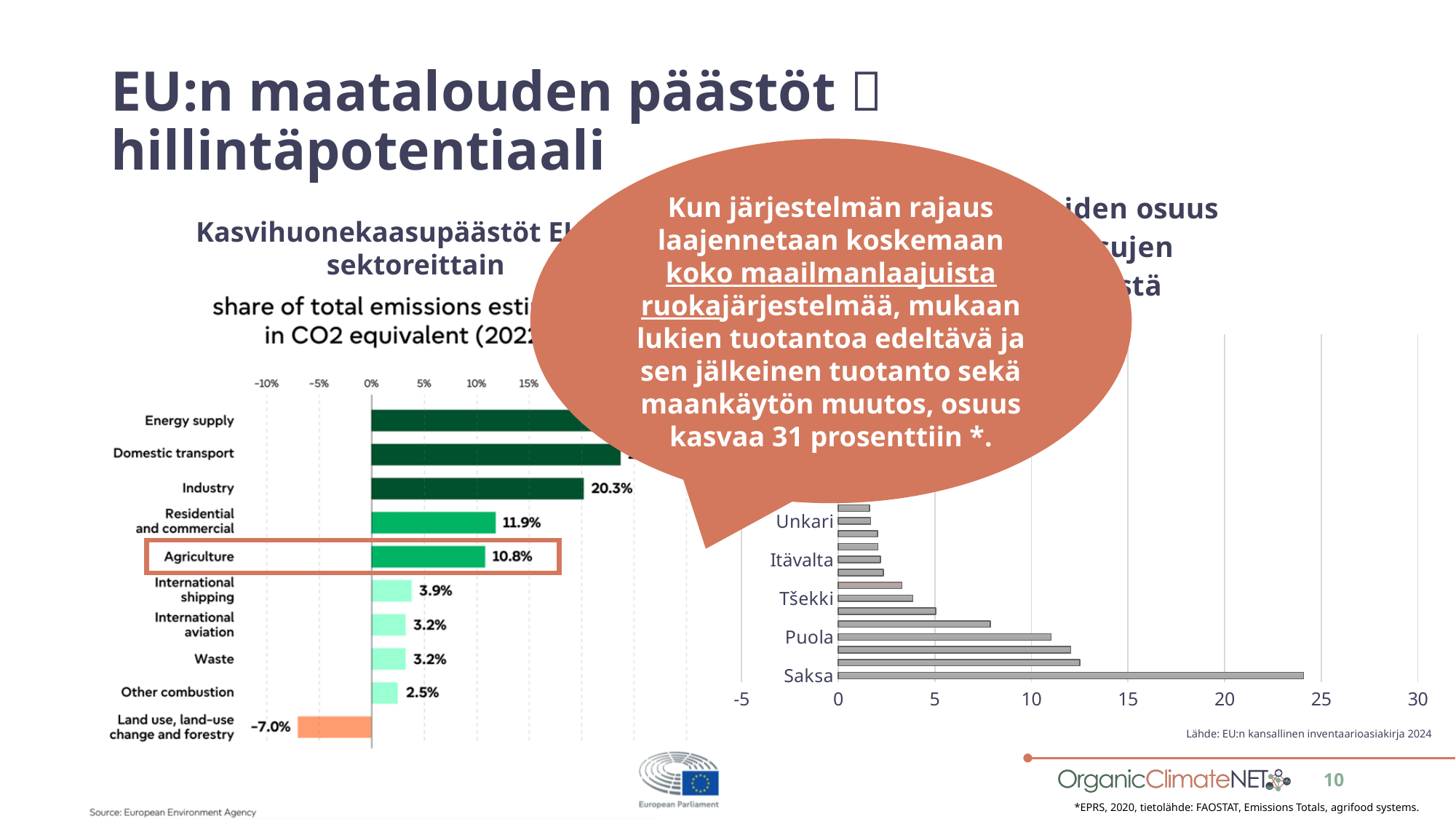
In the left chart (share of total emissions by sector), which sector has the lowest value? Land use, land-use change and forestry In the left chart (share of total emissions by sector), what is the difference between Residential and commercial and Agriculture? 1.1% What kind of chart is the left chart (share of total emissions by sector)? Bar chart In the left chart (share of total emissions by sector), what is the value for Industry? 20.3% In the right chart (by country), is the value for Saksa greater or less than 20? greater In the left chart (share of total emissions by sector), what is the value for Land use, land-use change and forestry? -7.0% In the left chart (share of total emissions by sector), what is the value for International shipping? 3.9% In the right chart (by country), is the value for Unkari greater or less than 5? less In the left chart (share of total emissions by sector), how many sectors are plotted? 10 In the left chart (share of total emissions by sector), which is larger, Industry or Agriculture? Industry In the left chart (share of total emissions by sector), what is the value for Agriculture? 10.8% In the left chart (share of total emissions by sector), what is the value for Residential and commercial? 11.9%